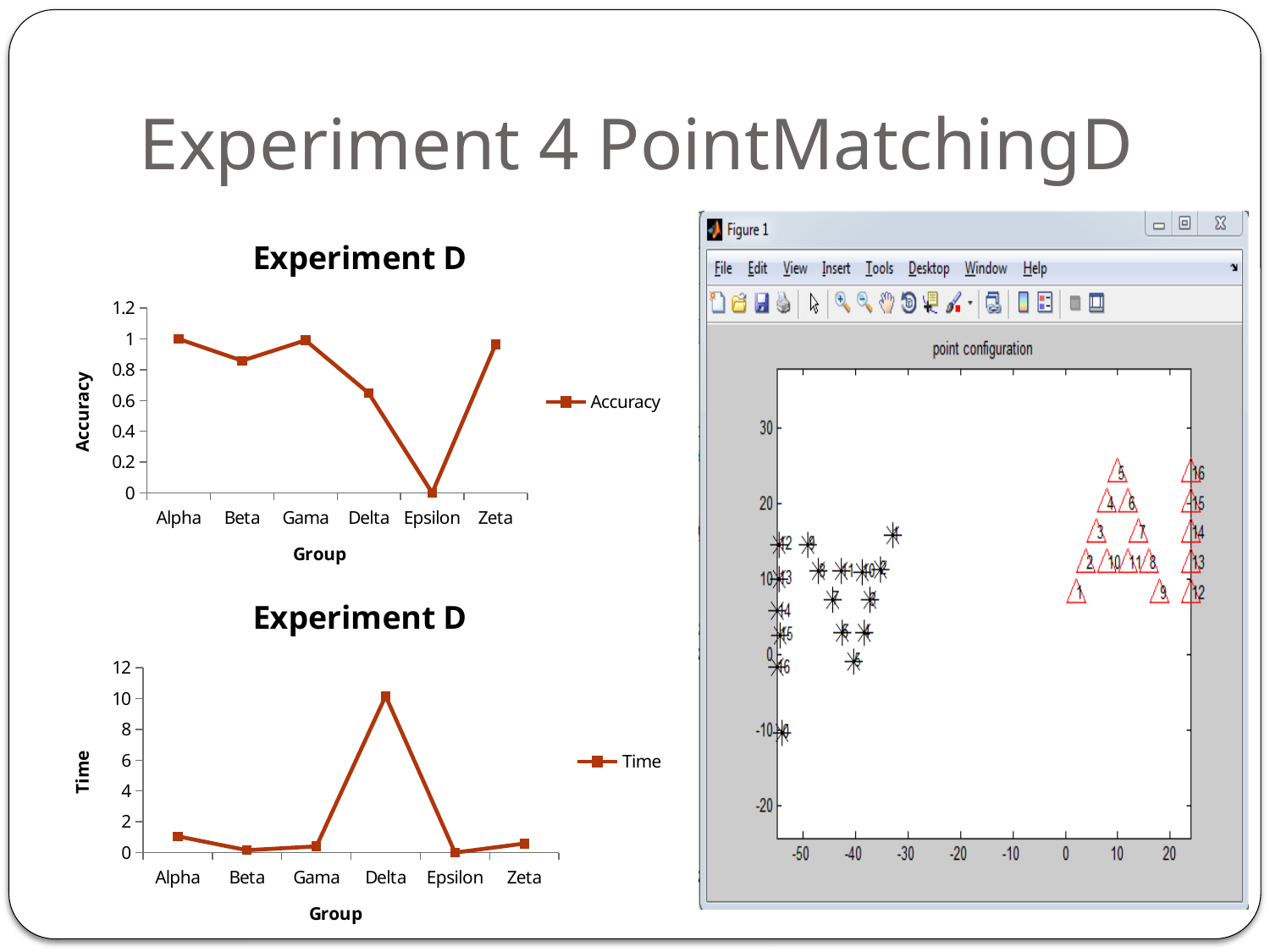
In the top 'Experiment D' chart (Accuracy), is the value for Delta greater or less than 0.8? less In the top 'Experiment D' chart (Accuracy), what is the accuracy value for Epsilon? 0 How many groups are plotted on the x axis of the top 'Experiment D' chart (Accuracy)? 6 In the top 'Experiment D' chart (Accuracy), which group has the lowest accuracy? Epsilon In the top 'Experiment D' chart (Accuracy), which group has the higher accuracy, Beta or Delta? Beta How many series does the legend of the top 'Experiment D' chart list? 1 In the bottom 'Experiment D' chart (Time), which group has the higher time, Alpha or Beta? Alpha In the bottom 'Experiment D' chart (Time), which group has the highest time? Delta What kind of chart is the top 'Experiment D' chart (Accuracy)? line chart What is the y-axis label of the bottom 'Experiment D' chart? Time In the top 'Experiment D' chart (Accuracy), do the values rise or fall from Gama to Epsilon? fall In the bottom 'Experiment D' chart (Time), is the value for Delta greater or less than 8? greater